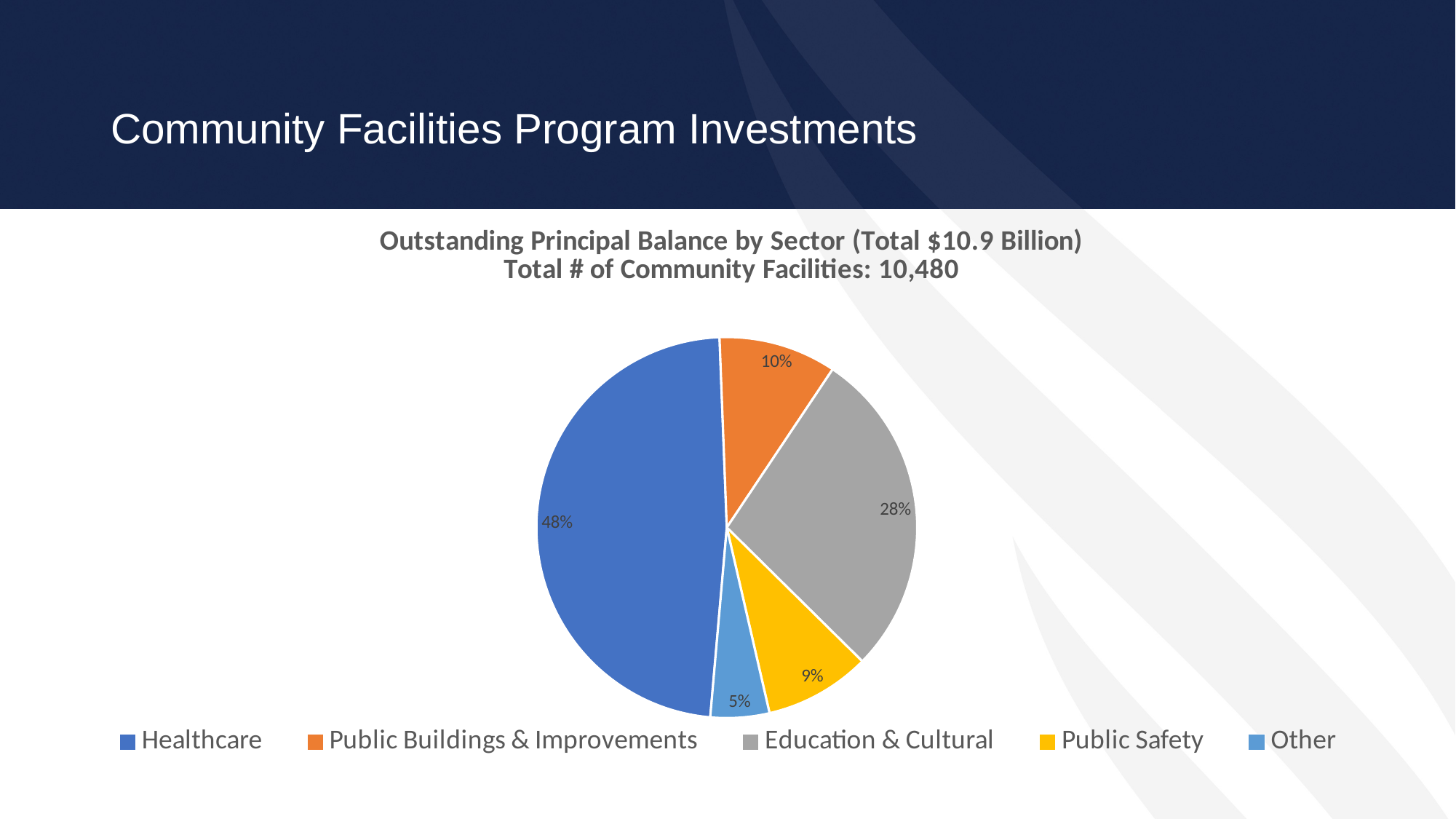
Which sector has the largest share of the outstanding principal balance? Healthcare How many sectors are shown in the pie chart? 5 Which sector has the smallest share of the outstanding principal balance? Other What is the difference in percentage points between Healthcare and Education & Cultural? 20 What type of chart is shown on the slide? Pie chart What percentage of the pie is Education & Cultural? 28% Which is larger, the share for Public Buildings & Improvements or the share for Public Safety? Public Buildings & Improvements What share does the Other slice represent? 5% What percentage is shown for Public Safety? 9% What share of the outstanding principal balance does Healthcare account for? 48% What is the value shown for Public Buildings & Improvements? 10% What total outstanding principal balance is stated in the chart title? $10.9 Billion